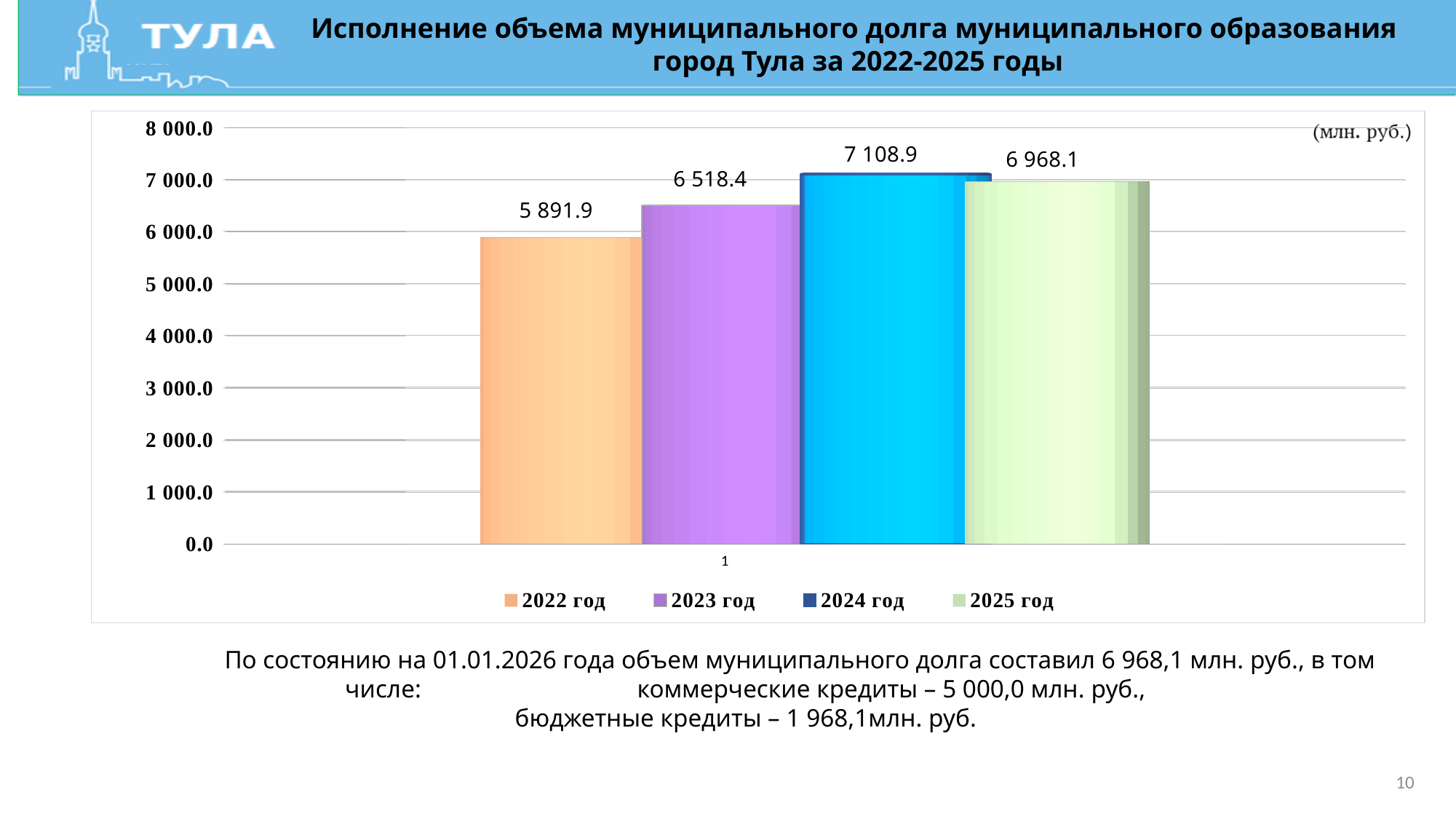
Which year has the highest value? 2024 год How many series does the legend list? 4 What is the value for 2022 год? 5 891.9 What unit is indicated in the top right corner of the chart? млн. руб. What is the value for 2024 год? 7 108.9 What kind of chart is shown on the slide? bar chart Is the value for 2022 год greater or less than 6 000.0? less Which year has the lowest value? 2022 год What is the value for 2025 год? 6 968.1 What is the difference between the values for 2025 год and 2022 год? 1 076.2 What is the difference between the values for 2024 год and 2023 год? 590.5 Which is larger, the value for 2023 год or the value for 2025 год? 2025 год